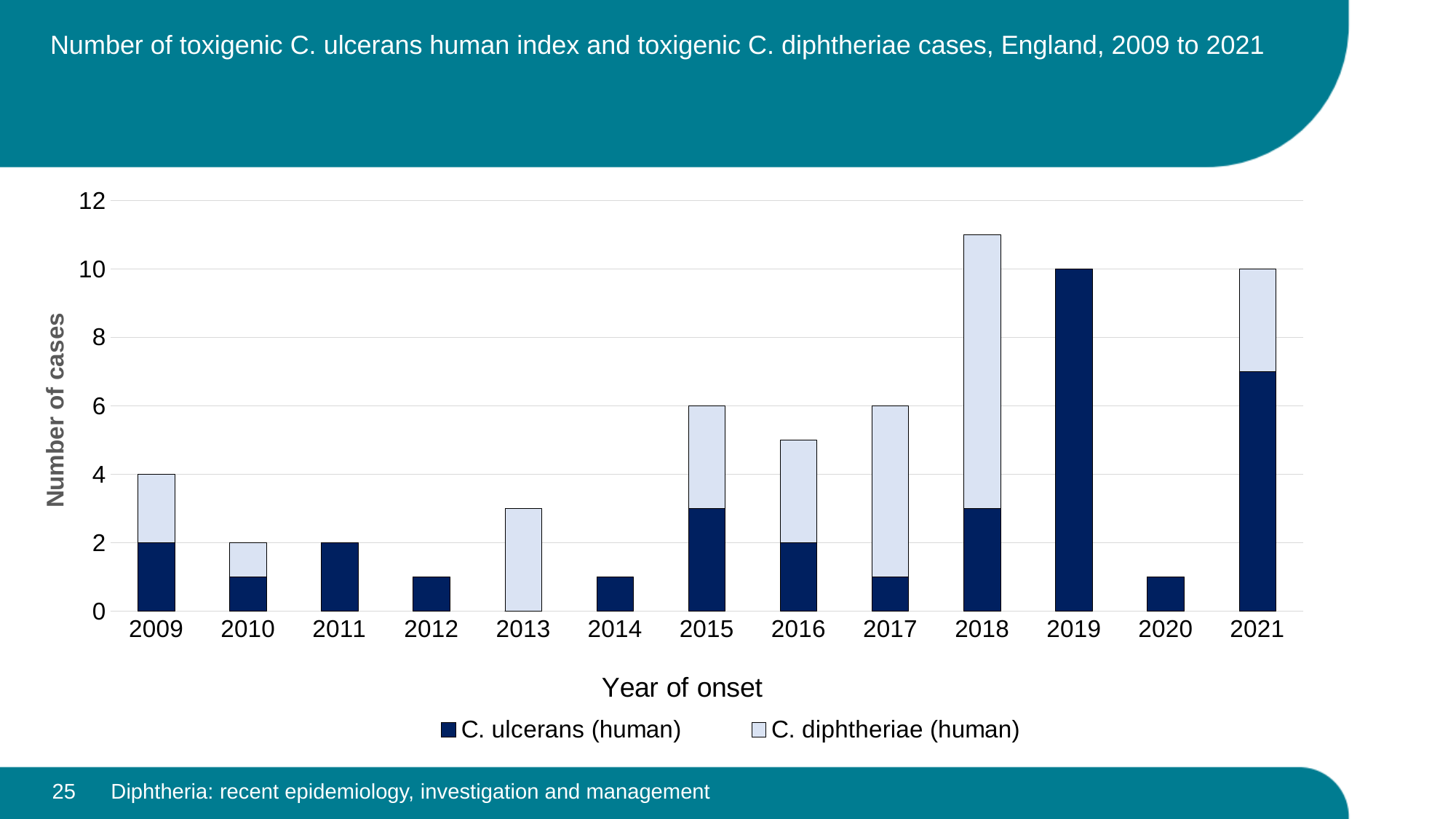
How many series does the legend list? 2 What is the number of C. ulcerans (human) cases in 2011? 2 Which year has the highest total number of cases? 2018 Which year has more total cases, 2015 or 2010? 2015 What is the number of C. ulcerans (human) cases in 2019? 10 What is the total number of cases in 2009? 4 What type of chart is shown on the slide? Stacked bar chart How many years are shown on the x axis? 13 Is the number of C. ulcerans (human) cases in 2021 greater or less than 6? greater Which year has the highest number of C. ulcerans (human) cases? 2019 Is the total number of cases in 2018 greater or less than 10? greater What is the total number of cases in 2021? 10